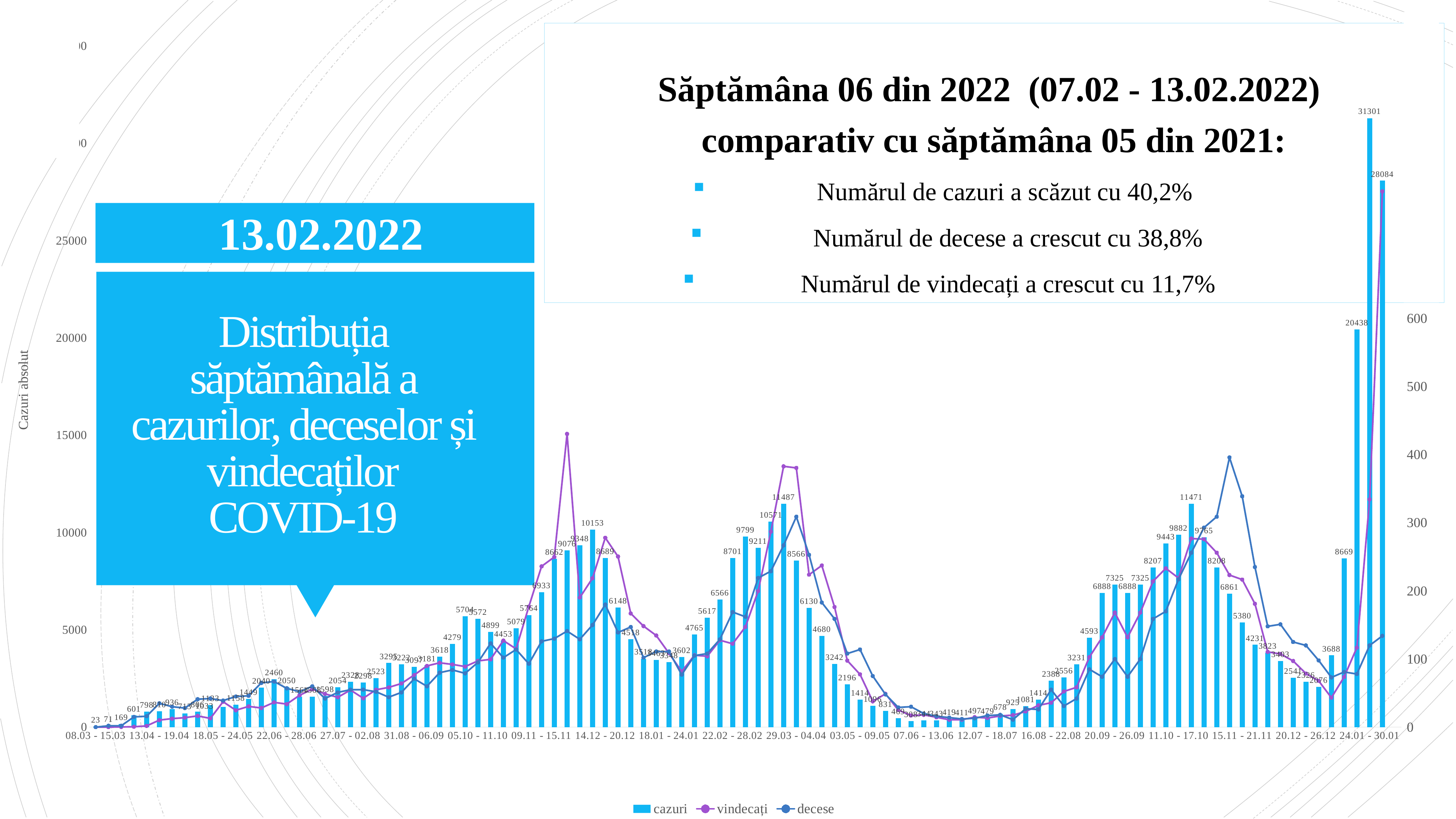
What is the highest tick value on the right-hand axis? 600 Which is larger, the cazuri bar labelled 11487 or the one labelled 10153? 11487 What is the value of the first cazuri bar on the left of the chart? 23 What colour are the cazuri bars in the legend? blue What is the lowest labelled cazuri value on the chart? 23 Is the peak of the vindecați line greater or less than 10000? greater What is the difference between the two tallest cazuri bars, 31301 and 28084? 3217 What is the value of the third-tallest cazuri bar, just before the two tallest ones? 20438 What is the value of the tallest cazuri bar? 31301 What is the difference between the cazuri bars labelled 11487 and 10153? 1334 What kind of chart is shown on the slide? bar and line chart How many series does the legend list? 3